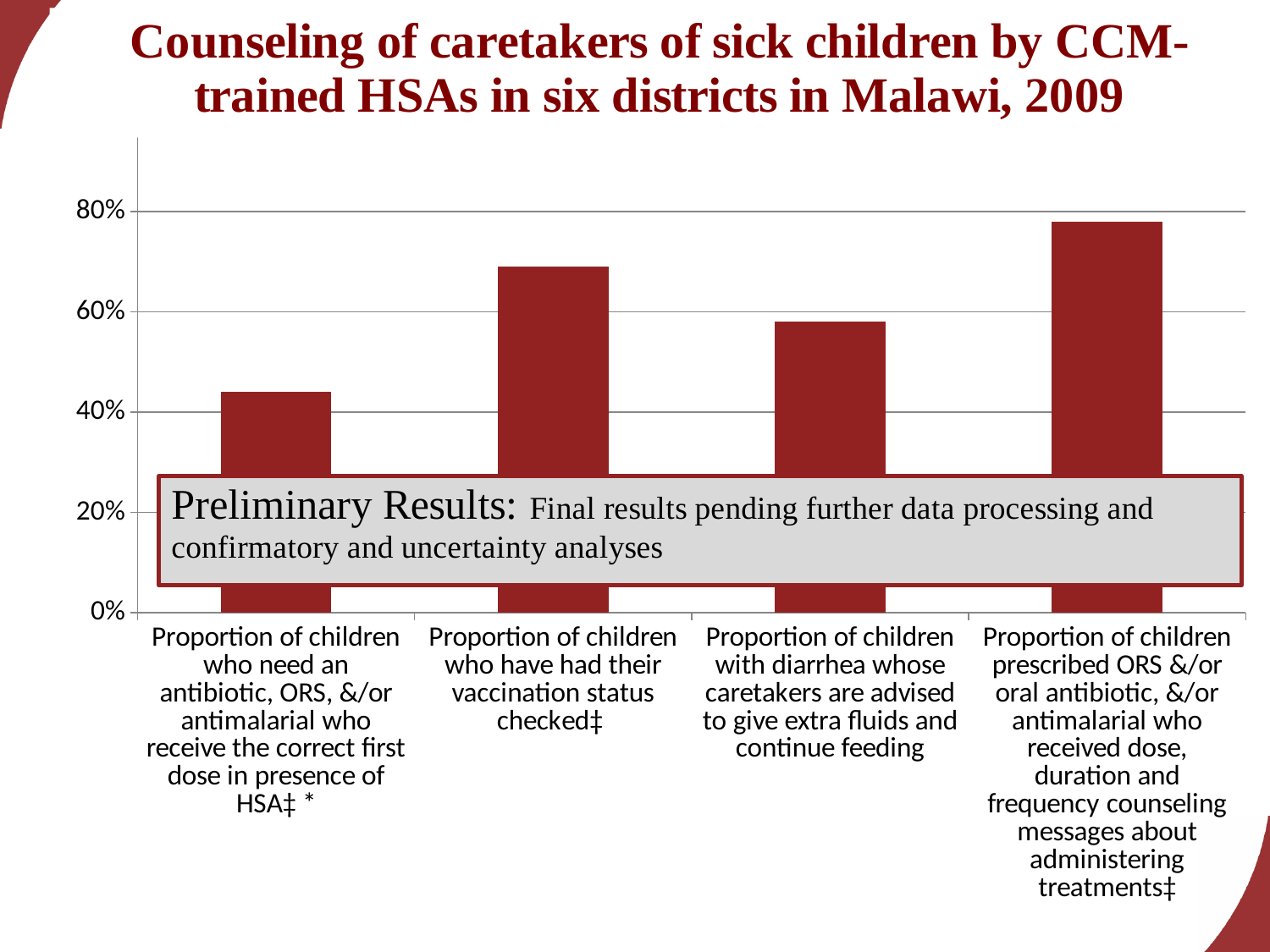
Is the value for the proportion of children who have had their vaccination status checked greater or less than 60%? greater How many bars (categories) does the chart show? 4 Which is larger: the proportion of children who need an antibiotic, ORS, &/or antimalarial who receive the correct first dose in presence of HSA, or the proportion of children with diarrhea whose caretakers are advised to give extra fluids and continue feeding? Proportion of children with diarrhea whose caretakers are advised to give extra fluids and continue feeding Which category has the lowest bar? Proportion of children who need an antibiotic, ORS, &/or antimalarial who receive the correct first dose in presence of HSA Which is larger: the proportion of children who have had their vaccination status checked, or the proportion of children with diarrhea whose caretakers are advised to give extra fluids and continue feeding? Proportion of children who have had their vaccination status checked Is the value for the proportion of children with diarrhea whose caretakers are advised to give extra fluids and continue feeding greater or less than 40%? greater Is the value for the proportion of children prescribed ORS &/or oral antibiotic, &/or antimalarial who received dose, duration and frequency counseling messages greater or less than 80%? less What is the highest value shown on the vertical axis? 80% What kind of chart is shown on the slide? bar chart Which category has the highest bar? Proportion of children prescribed ORS &/or oral antibiotic, &/or antimalarial who received dose, duration and frequency counseling messages about administering treatments What is the title of the chart on the slide? Counseling of caretakers of sick children by CCM-trained HSAs in six districts in Malawi, 2009